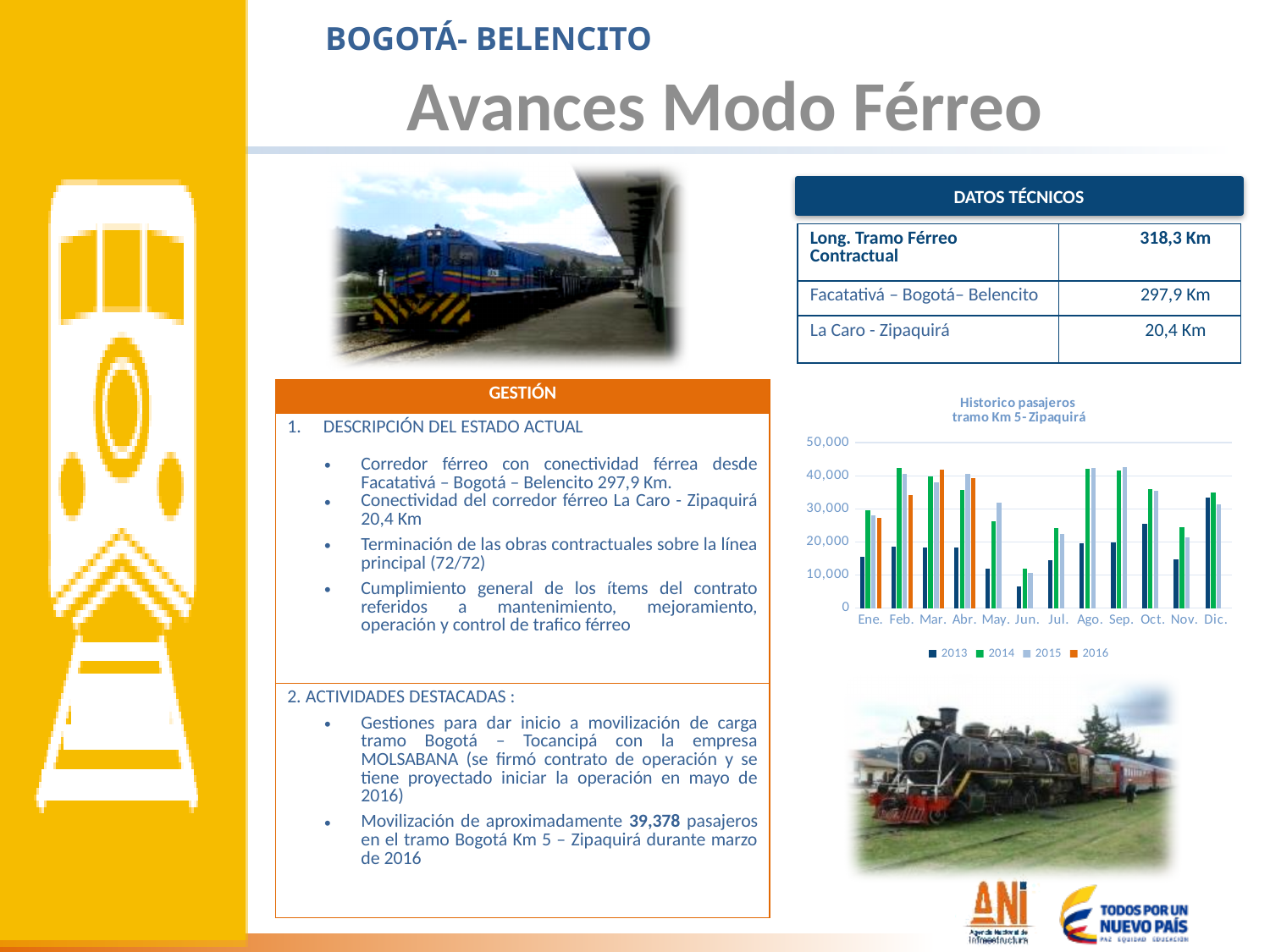
Which years are listed in the chart legend? 2013, 2014, 2015, 2016 How many series does the chart legend list? 4 In Ene., which is larger, the value for 2013 or the value for 2014? 2014 Is the value for 2013 in Dic. greater or less than 30,000? greater Is the value for 2014 in Feb. greater or less than 40,000? greater In which month is the 2013 value highest? Dic. What kind of chart is shown on the slide? bar chart What is the title of the chart? Historico pasajeros tramo Km 5 - Zipaquirá In which month is the 2013 value lowest? Jun. How many months are shown on the x axis of the chart? 12 Is the value for 2016 in Mar. greater or less than 40,000? greater